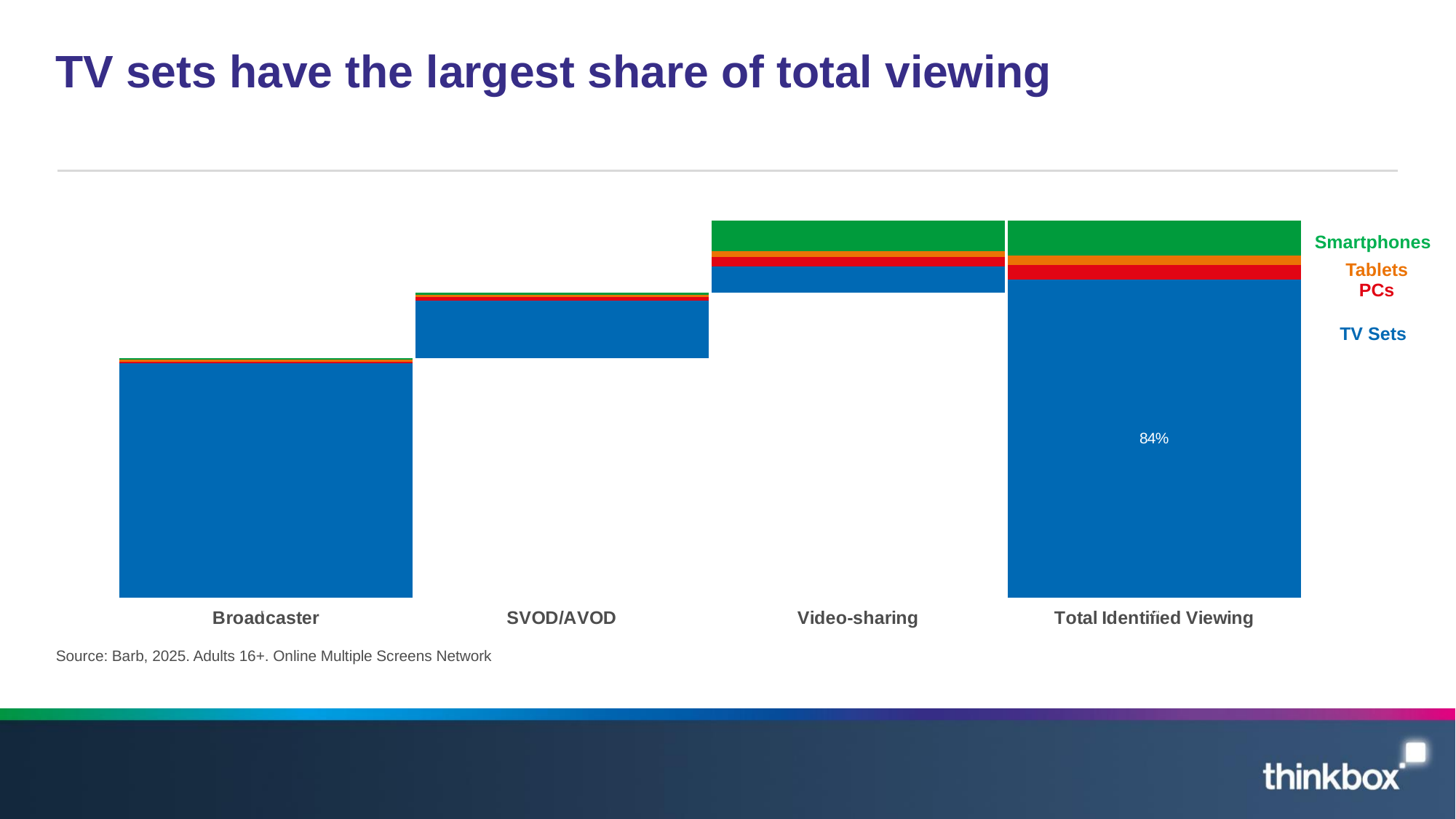
What is the title of the slide? TV sets have the largest share of total viewing Which category has the largest TV Sets segment? Total Identified Viewing Which series is shown in blue in the chart? TV Sets What percentage label is shown on the TV Sets segment of the Total Identified Viewing bar? 84% How many series does the chart's legend list? 4 Which category has the smallest TV Sets segment? Video-sharing What kind of chart is shown on the slide? Stacked bar chart Is the TV Sets segment larger for Broadcaster or for SVOD/AVOD? Broadcaster Is the Smartphones segment larger for Broadcaster or for Video-sharing? Video-sharing How many categories are shown along the x axis of the chart? 4 Which series makes up the largest part of the Total Identified Viewing bar? TV Sets